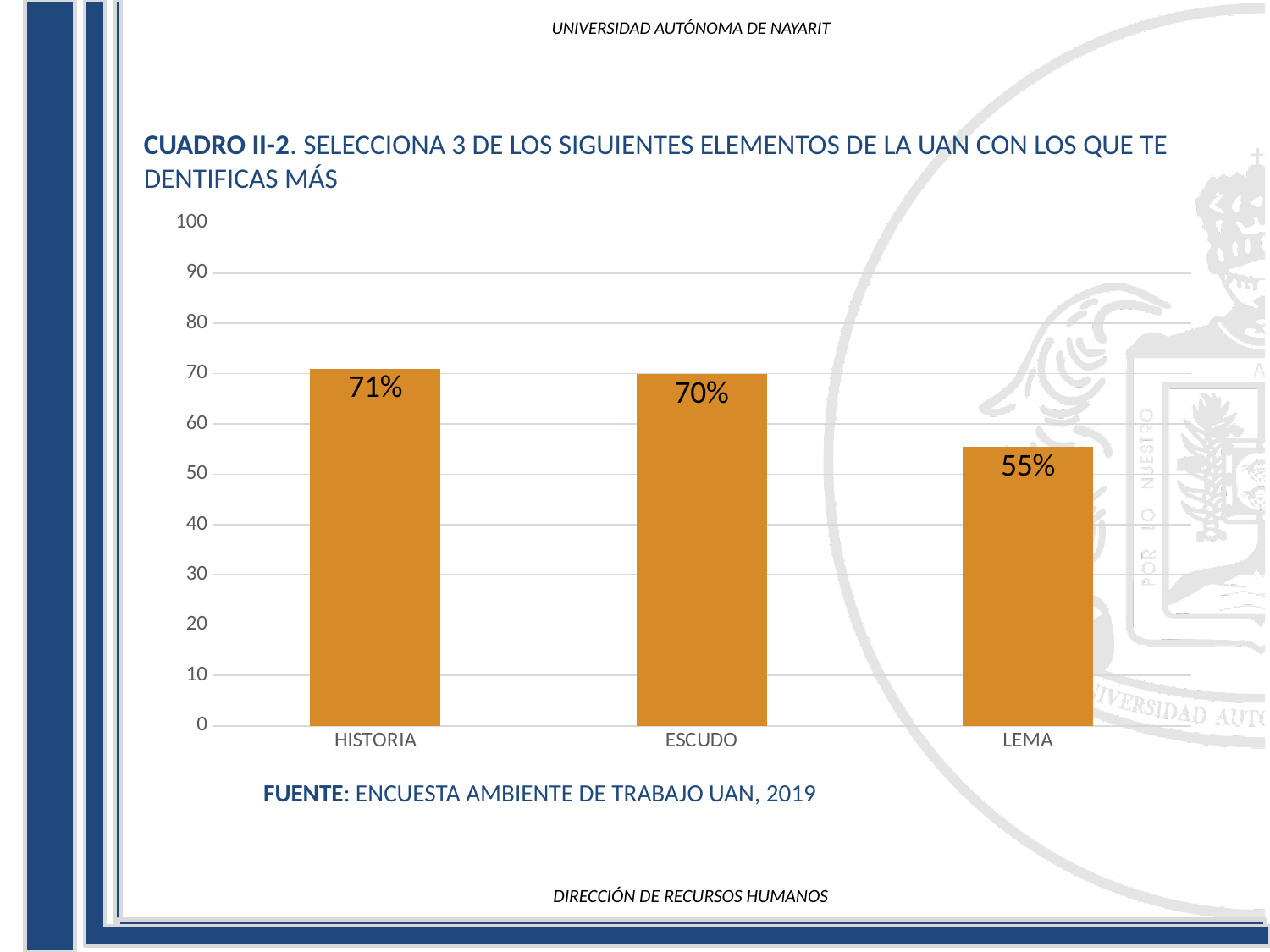
What is the value for HISTORIA? 71% Is the value for HISTORIA greater or less than 70? greater What source is cited below the chart? ENCUESTA AMBIENTE DE TRABAJO UAN, 2019 What is the difference between the values for ESCUDO and LEMA? 15% What is the difference between the values for HISTORIA and LEMA? 16% What kind of chart is shown on the slide? bar chart What is the value for LEMA? 55% Which category has the lowest value? LEMA What is the value for ESCUDO? 70% Is the value for LEMA greater or less than 60? less Which is larger, the value for ESCUDO or the value for LEMA? ESCUDO How many categories are shown on the x axis? 3